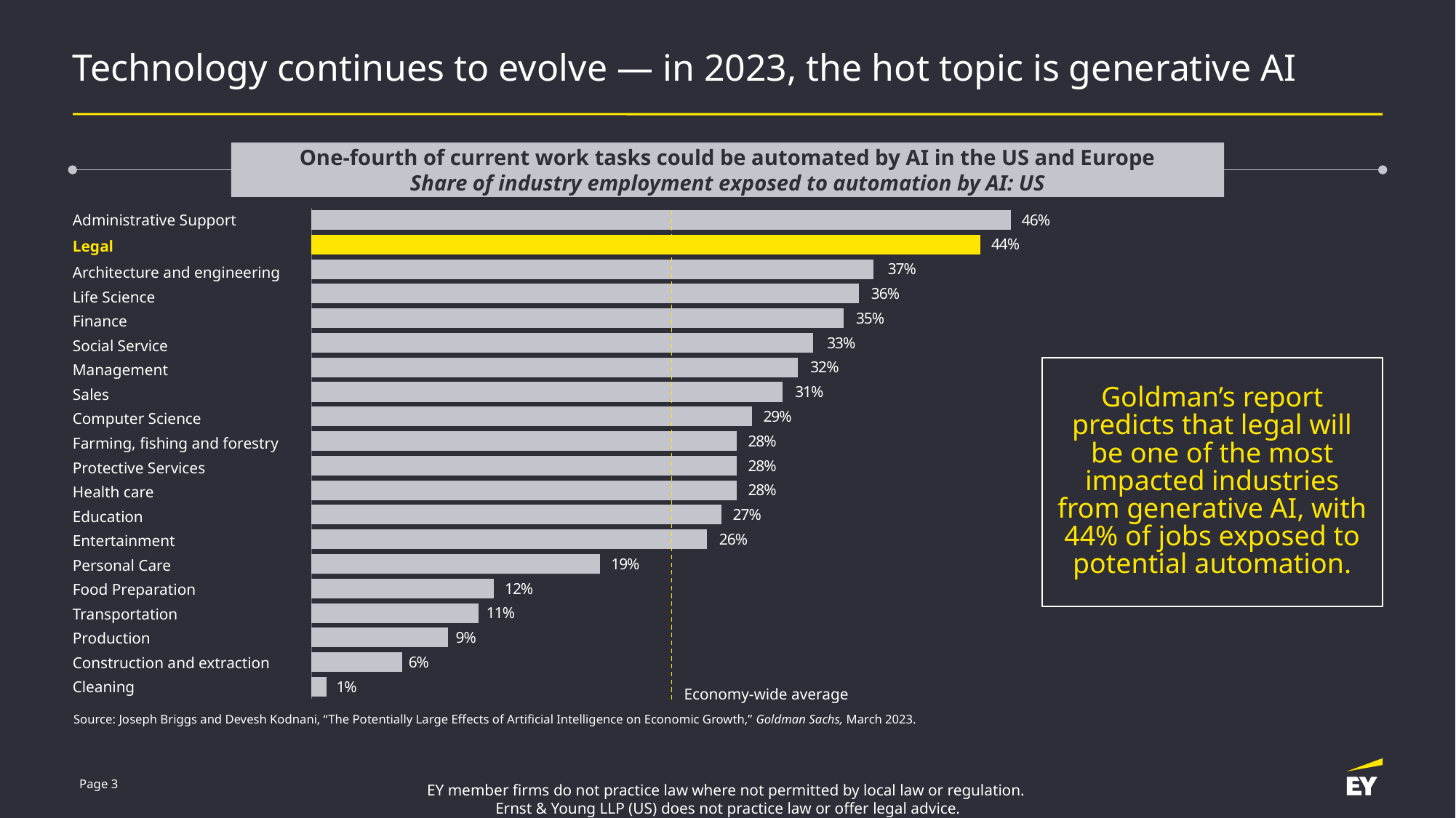
What is the difference between the values for Administrative Support and Legal? 2% What is the value for Legal? 44% What is the difference between the values for Life Science and Food Preparation? 24% Which industry has the lowest share of employment exposed to automation by AI? Cleaning What kind of chart is shown on the slide? Bar chart How many industries are shown in the chart? 20 Which industry has the highest share of employment exposed to automation by AI? Administrative Support What does the dashed vertical line in the chart represent? Economy-wide average What is the value for Finance? 35% What is the value for Personal Care? 19% Which bar is highlighted in yellow? Legal Which is larger, the value for Management or the value for Entertainment? Management